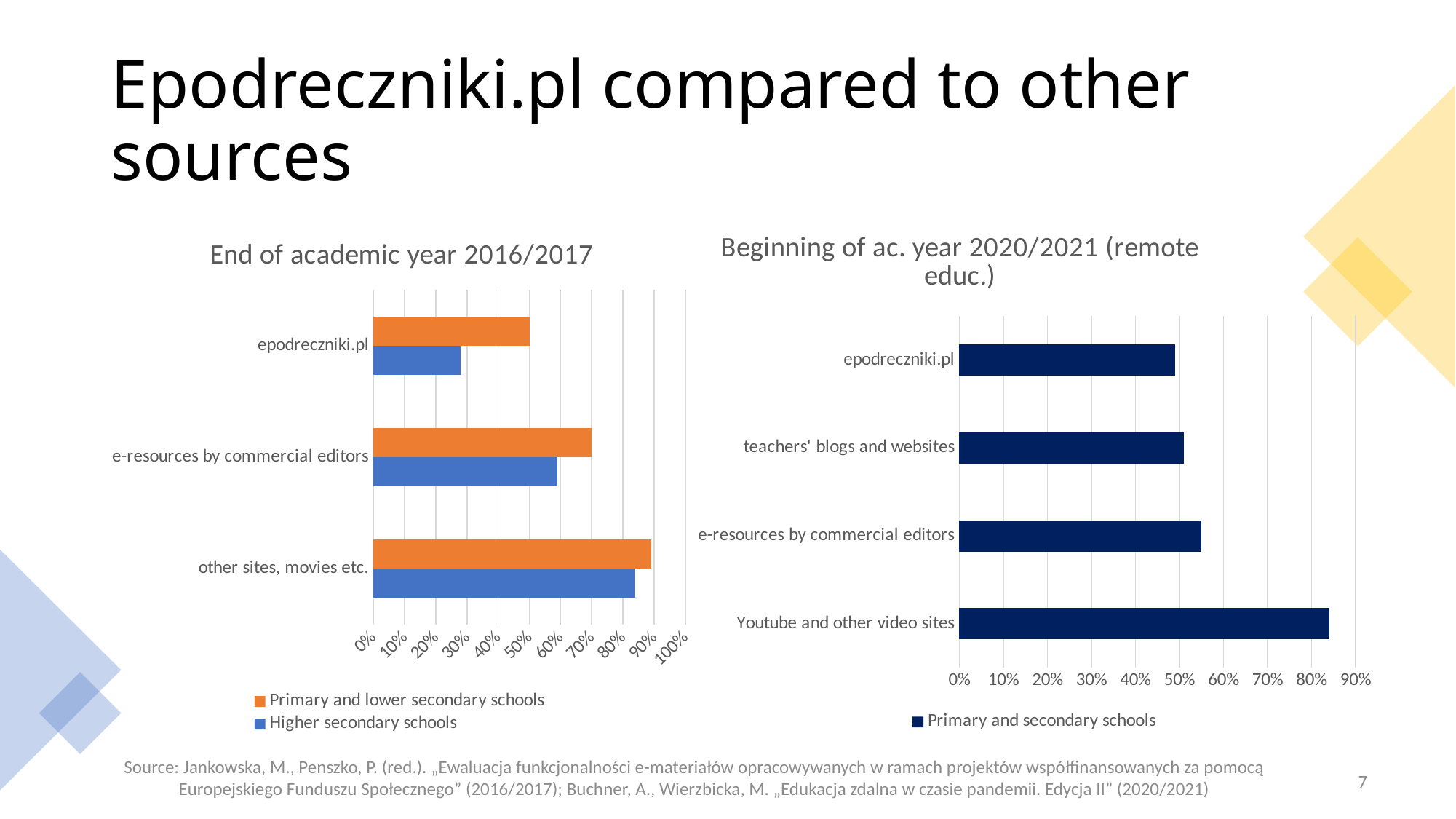
What kind of chart is the 'End of academic year 2016/2017' chart? bar chart What series name is shown in the legend of the 'Beginning of ac. year 2020/2021 (remote educ.)' chart? Primary and secondary schools In the 'End of academic year 2016/2017' chart, which category has the lowest value for Higher secondary schools? epodreczniki.pl In the 'End of academic year 2016/2017' chart, for epodreczniki.pl, which series has the larger value: Primary and lower secondary schools or Higher secondary schools? Primary and lower secondary schools In the 'Beginning of ac. year 2020/2021 (remote educ.)' chart, is the value for teachers' blogs and websites greater or less than 60%? less In the 'End of academic year 2016/2017' chart, which category has the highest value for Primary and lower secondary schools? other sites, movies etc. In the 'Beginning of ac. year 2020/2021 (remote educ.)' chart, which category has the highest value? Youtube and other video sites How many series does the legend of the 'End of academic year 2016/2017' chart list? 2 In the 'End of academic year 2016/2017' chart, is the value for epodreczniki.pl for Higher secondary schools greater or less than 40%? less In the 'Beginning of ac. year 2020/2021 (remote educ.)' chart, is the value for Youtube and other video sites greater or less than 80%? greater How many categories are shown in the 'Beginning of ac. year 2020/2021 (remote educ.)' chart? 4